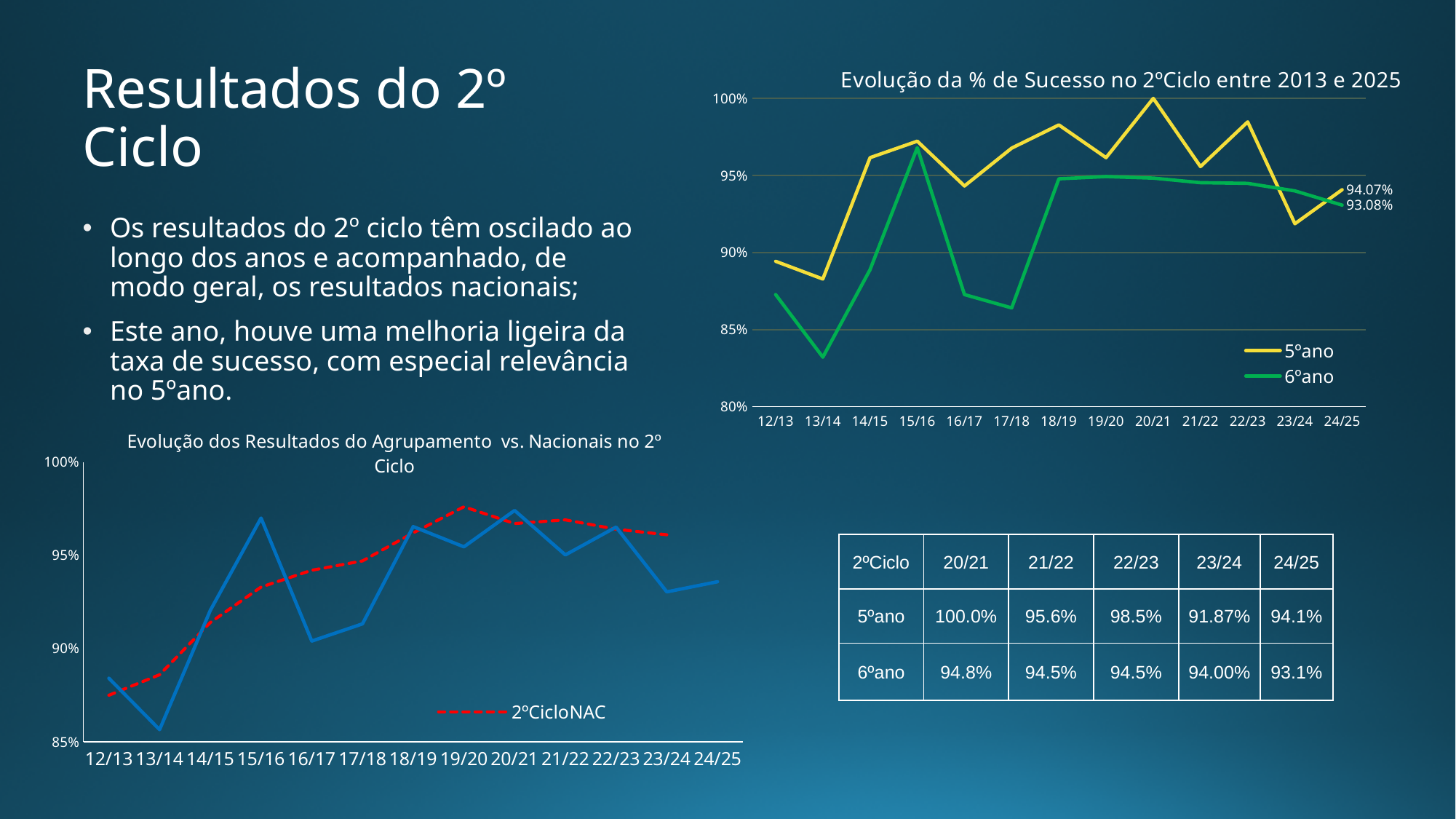
In the top-right chart 'Evolução da % de Sucesso no 2ºCiclo entre 2013 e 2025', is the 6ºano value for 13/14 greater or less than 85%? less In the bottom-left chart 'Evolução dos Resultados do Agrupamento vs. Nacionais no 2º Ciclo', is the value of the solid blue line for 13/14 greater or less than 90%? less In the top-right chart 'Evolução da % de Sucesso no 2ºCiclo entre 2013 e 2025', what is the difference between the 5ºano and 6ºano values in 24/25? 0.99% What kind of chart is the bottom-left chart titled 'Evolução dos Resultados do Agrupamento vs. Nacionais no 2º Ciclo'? line chart In the top-right chart 'Evolução da % de Sucesso no 2ºCiclo entre 2013 e 2025', what is the value for 6ºano in 24/25? 93.08% How many school years are plotted along the x axis of the top-right chart 'Evolução da % de Sucesso no 2ºCiclo entre 2013 e 2025'? 13 In the top-right chart 'Evolução da % de Sucesso no 2ºCiclo entre 2013 e 2025', how many series does the legend list? 2 In the top-right chart 'Evolução da % de Sucesso no 2ºCiclo entre 2013 e 2025', what is the value for 5ºano in 24/25? 94.07% In the top-right chart 'Evolução da % de Sucesso no 2ºCiclo entre 2013 e 2025', in which year is the 6ºano value lowest? 13/14 In the top-right chart 'Evolução da % de Sucesso no 2ºCiclo entre 2013 e 2025', which series has the higher value in 18/19, 5ºano or 6ºano? 5ºano In the top-right chart 'Evolução da % de Sucesso no 2ºCiclo entre 2013 e 2025', in which year is the 5ºano value highest? 20/21 What kind of chart is the top-right chart titled 'Evolução da % de Sucesso no 2ºCiclo entre 2013 e 2025'? line chart